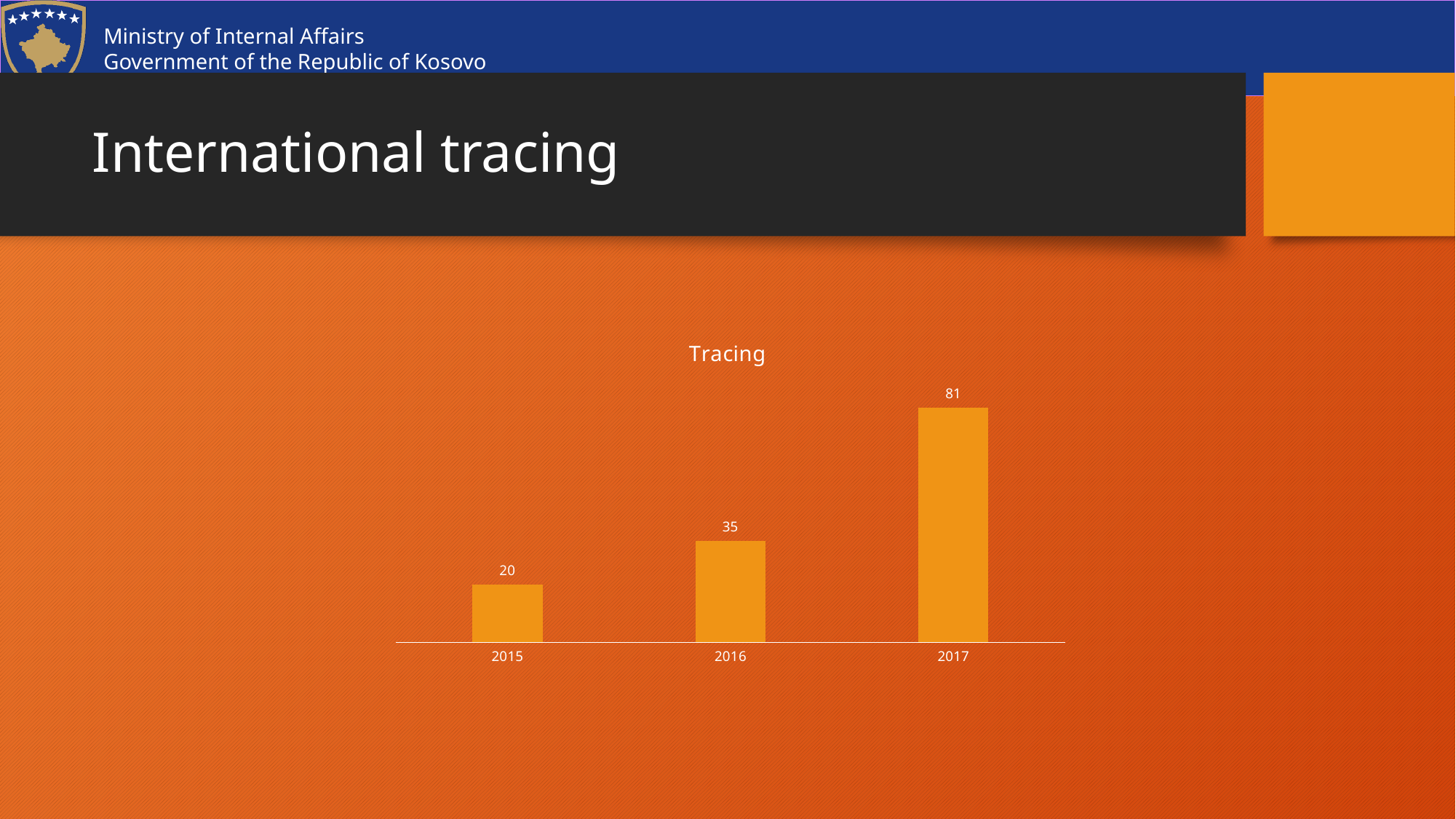
What is the difference between the values for 2017 and 2016? 46 Which year has the lowest value? 2015 What kind of chart is shown? Bar chart Do the values rise or fall from 2015 to 2017? Rise What is the value for 2017? 81 What is the difference between the values for 2016 and 2015? 15 What is the value for 2016? 35 How many years are shown on the chart? 3 Which is larger, the value for 2016 or the value for 2015? 2016 What is the title of the chart? Tracing Which year has the highest value? 2017 What is the value for 2015? 20